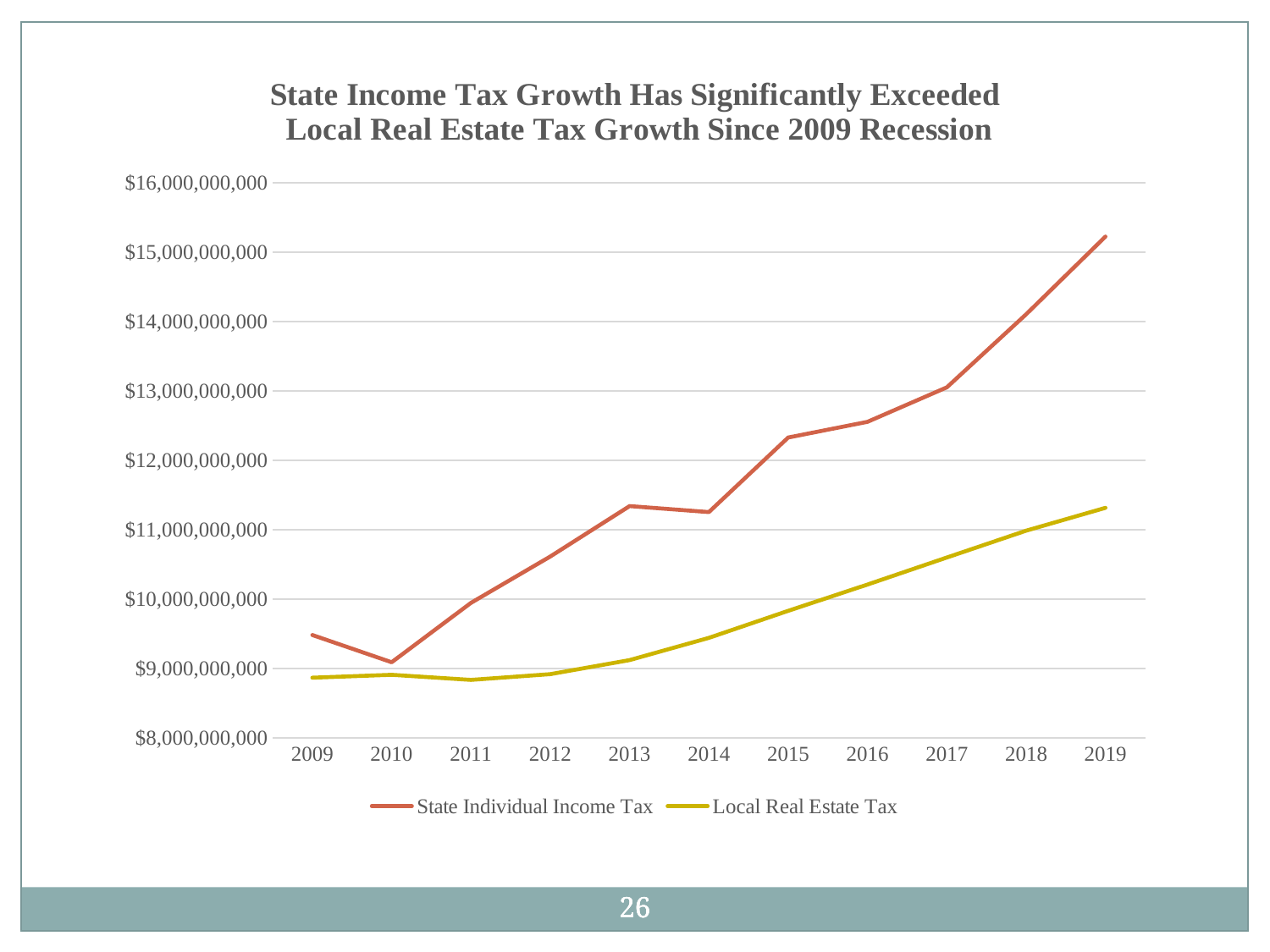
Is the State Individual Income Tax value for 2015 greater or less than $12,000,000,000? greater What kind of chart is shown on the slide? line chart Is the Local Real Estate Tax value for 2014 greater or less than $10,000,000,000? less How many years are plotted along the x axis? 11 Does the Local Real Estate Tax line generally rise or fall from 2011 to 2019? rise Is the State Individual Income Tax value for 2019 greater or less than $15,000,000,000? greater In which year is the State Individual Income Tax value lowest? 2010 How many series does the legend list? 2 In which year is the Local Real Estate Tax value highest? 2019 In 2013, which series has the larger value, State Individual Income Tax or Local Real Estate Tax? State Individual Income Tax In which year is the State Individual Income Tax value highest? 2019